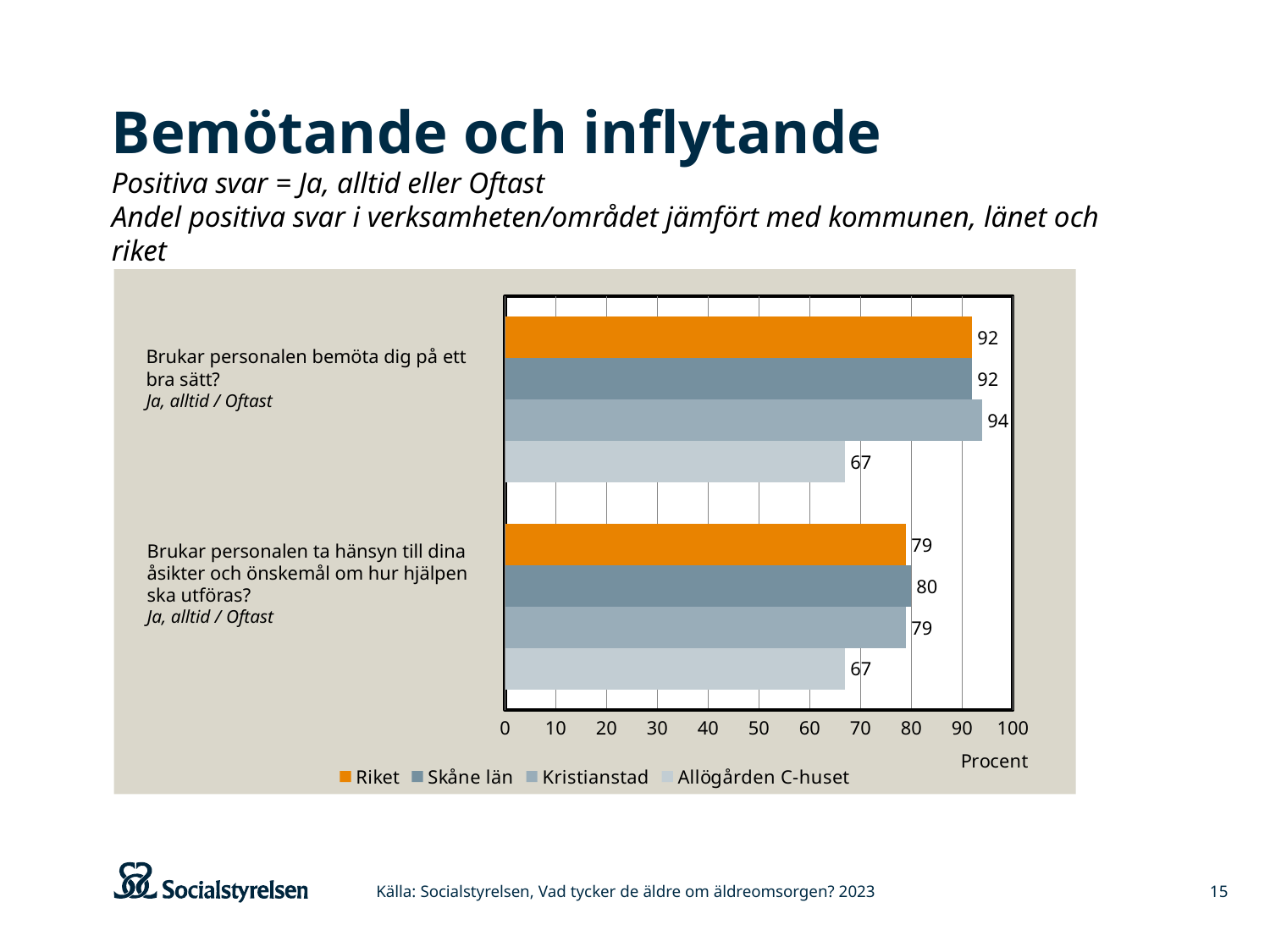
What kind of chart is shown on the slide? bar chart Which series has the lowest value on the question "Brukar personalen ta hänsyn till dina åsikter och önskemål om hur hjälpen ska utföras?"? Allögården C-huset What is the value for Kristianstad on the question "Brukar personalen bemöta dig på ett bra sätt?"? 94 Which is larger on the question "Brukar personalen ta hänsyn till dina åsikter och önskemål om hur hjälpen ska utföras?": Riket or Allögården C-huset? Riket How many series does the legend list? 4 Which series has the highest value on the question "Brukar personalen bemöta dig på ett bra sätt?"? Kristianstad What is the value for Skåne län on the question "Brukar personalen ta hänsyn till dina åsikter och önskemål om hur hjälpen ska utföras?"? 80 How many question categories are plotted on the chart? 2 What is the value for Allögården C-huset on the question "Brukar personalen ta hänsyn till dina åsikter och önskemål om hur hjälpen ska utföras?"? 67 Is the value for Riket on the question "Brukar personalen bemöta dig på ett bra sätt?" greater or less than 80? greater What is the difference between Kristianstad and Allögården C-huset on the question "Brukar personalen bemöta dig på ett bra sätt?"? 27 What unit is shown on the x axis of the chart? Procent